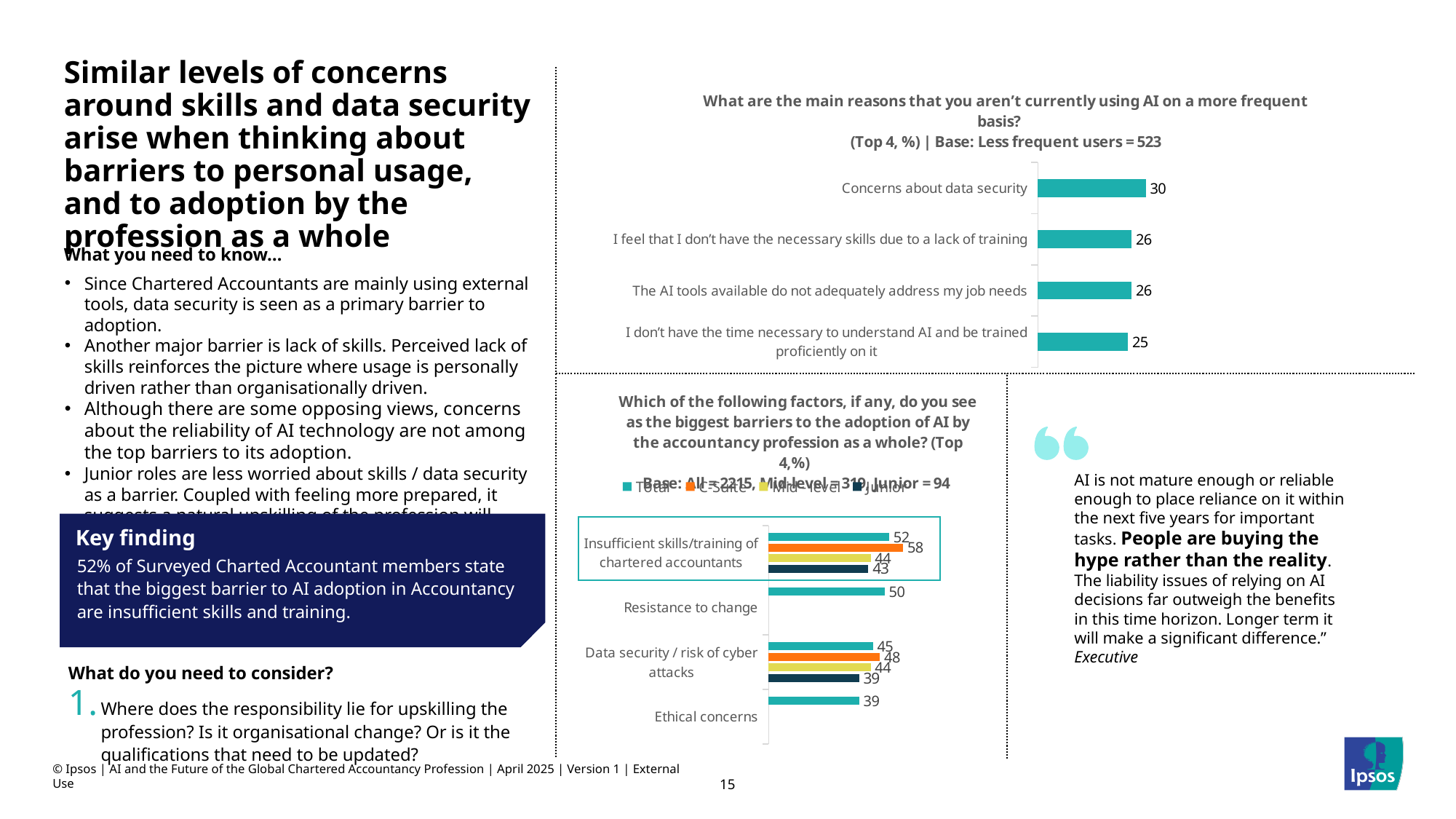
In the top chart on reasons for not using AI more frequently, what percentage cited concerns about data security? 30 In the top chart on reasons for not using AI more frequently, what is the difference between the value for concerns about data security and the value for not having the time necessary to understand AI? 5 In the bottom chart on barriers to AI adoption by the profession, what is the difference between the C-Suite and Junior values for insufficient skills/training of chartered accountants? 15 In the bottom chart on barriers to AI adoption by the profession, how many series does the legend list? 4 What type of chart is the top chart on reasons for not using AI more frequently? Bar chart In the bottom chart on barriers to AI adoption by the profession, what is the Total value for ethical concerns? 39 In the top chart on reasons for not using AI more frequently, which reason has the lowest value? I don't have the time necessary to understand AI and be trained proficiently on it In the top chart on reasons for not using AI more frequently, which reason has the highest value? Concerns about data security In the bottom chart on barriers to AI adoption by the profession, what is the C-Suite value for data security / risk of cyber attacks? 48 In the bottom chart on barriers to AI adoption by the profession, which is larger for insufficient skills/training: the C-Suite value or the Junior value? C-Suite In the top chart on reasons for not using AI more frequently, how many reasons are shown? 4 In the bottom chart on barriers to AI adoption by the profession, what is the Total value for insufficient skills/training of chartered accountants? 52